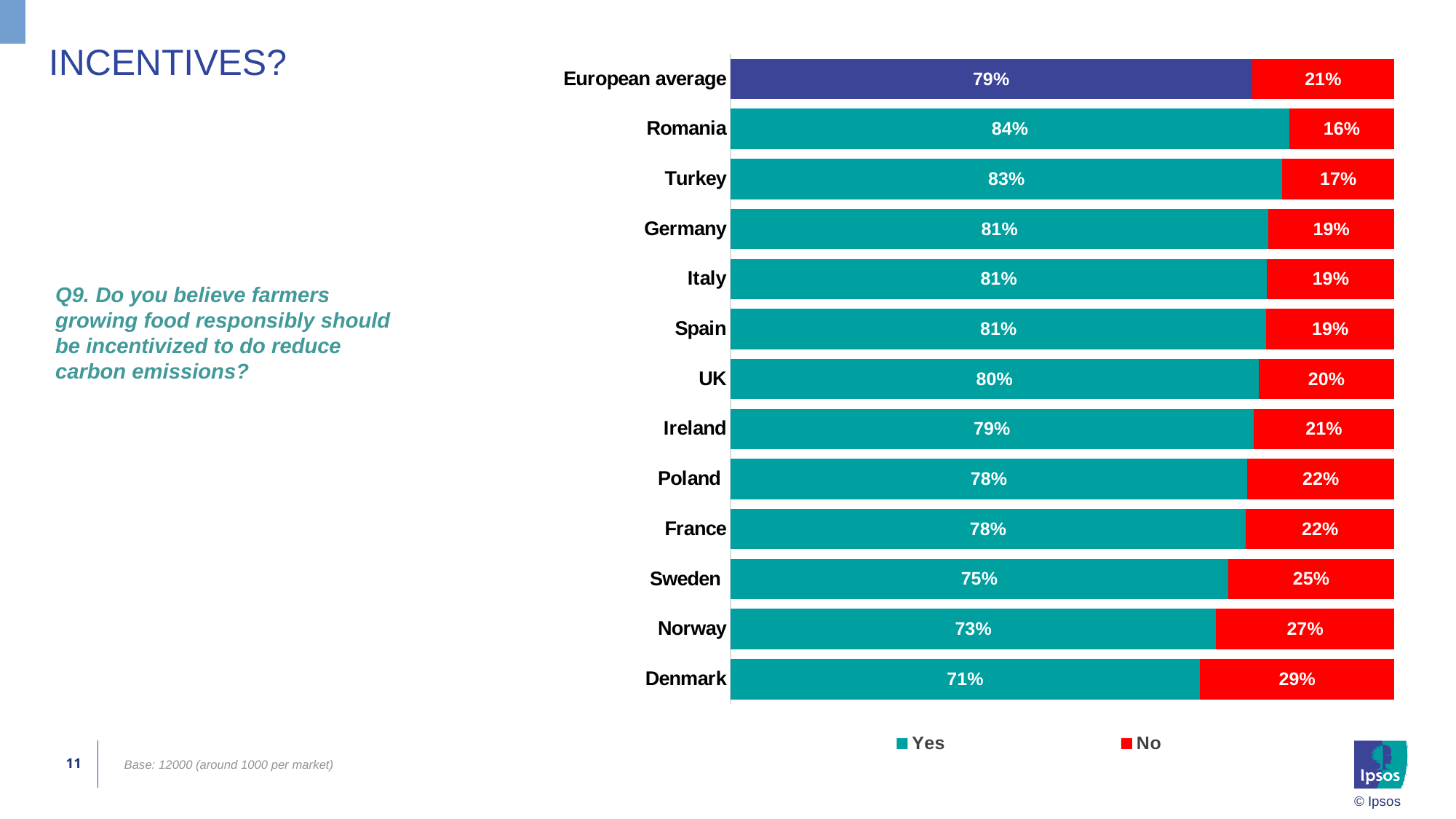
What is the European average Yes value? 79% Which colour represents the No responses in the chart? Red Which has a higher Yes value, Sweden or Norway? Sweden What is the total of the Yes and No values for Turkey? 100% Which country has the lowest Yes percentage? Denmark How many series does the legend list? 2 What percentage of respondents in Romania answered Yes? 84% Which country has the highest Yes percentage? Romania What type of chart is shown on the slide? Stacked bar chart What is the No value for Denmark? 29% How many countries (excluding the European average) are shown in the chart? 12 What is the difference between the Yes values for Romania and Denmark? 13 percentage points